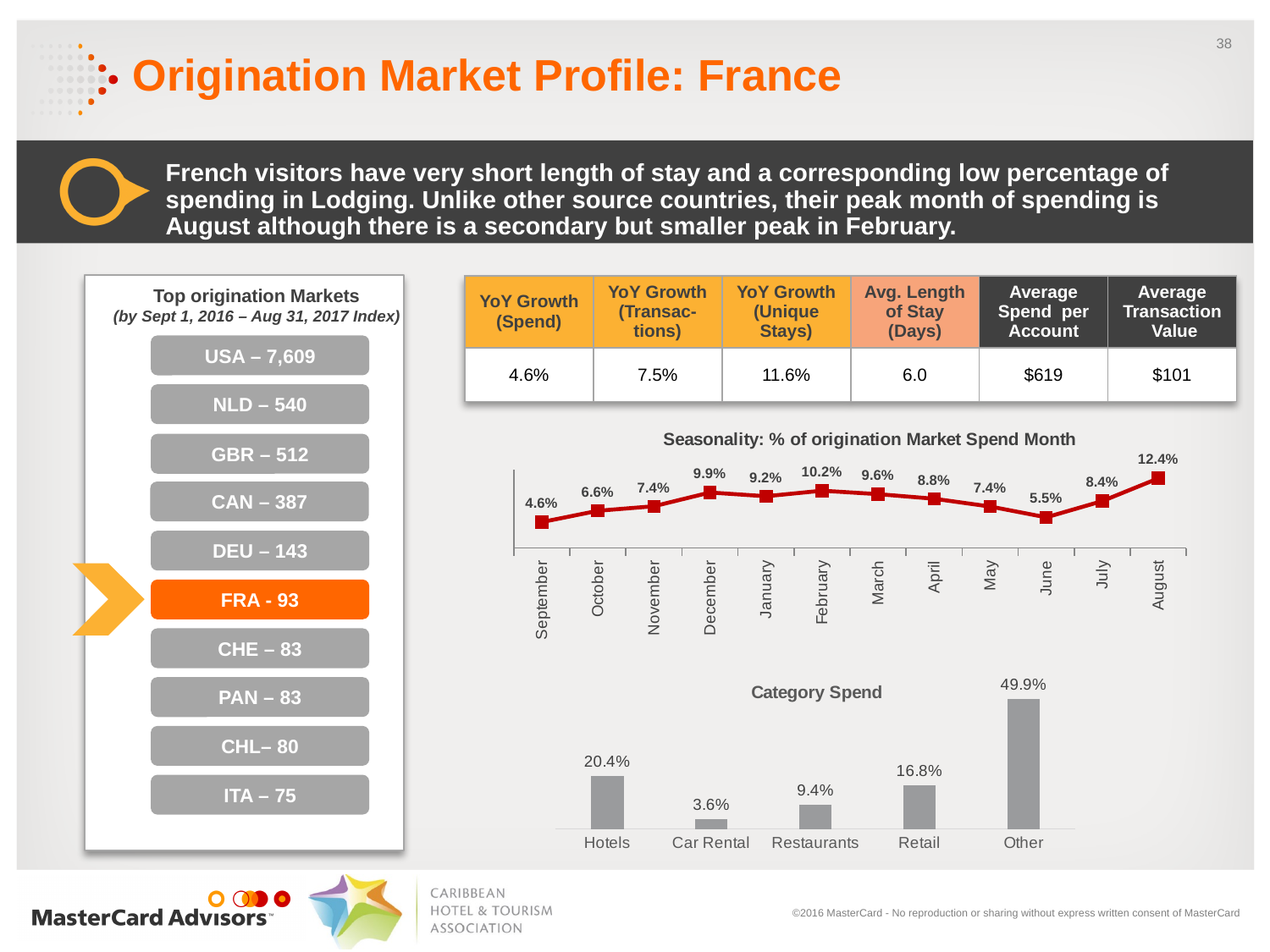
What kind of chart is the Category Spend chart? Bar chart In the Seasonality chart, what is the value for February? 10.2% In the Seasonality chart, which month has the lowest value? September In the Category Spend chart, which category has the lowest value? Car Rental In the Seasonality chart, how many months are plotted? 12 In the Category Spend chart, which is larger, Hotels or Restaurants? Hotels In the Seasonality chart, which month has the highest value? August In the Seasonality chart, what is the value for August? 12.4% In the Category Spend chart, what is the difference between Other and Hotels? 29.5% In the Seasonality chart, what is the difference between the values for August and June? 6.9% In the Category Spend chart, what is the value for Retail? 16.8% What kind of chart is the Seasonality chart? Line chart